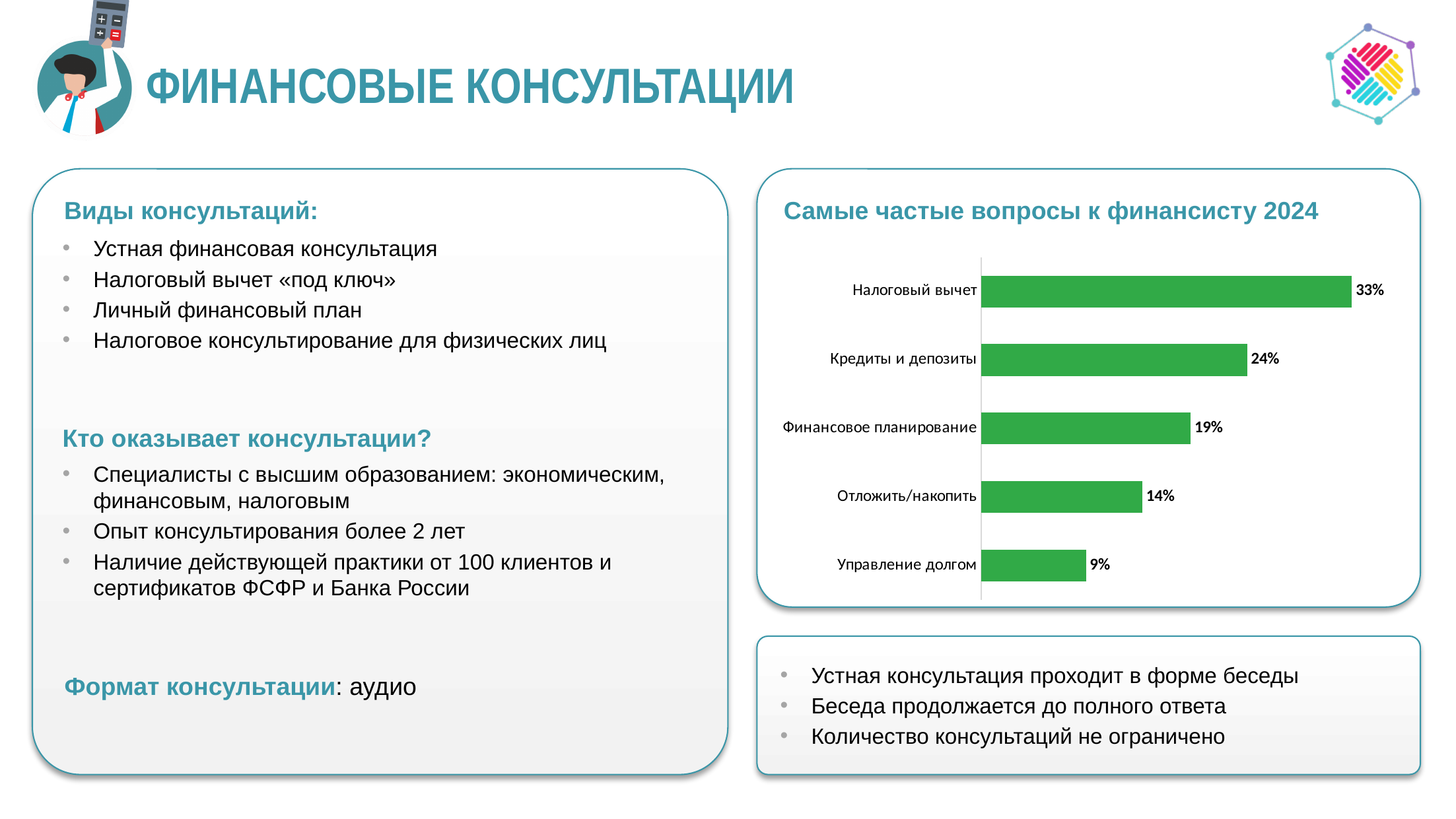
What is the difference between the values for Налоговый вычет and Кредиты и депозиты? 9% How many categories are shown in the chart? 5 What is the value for Управление долгом? 9% What is the value for Отложить/накопить? 14% Which category has the highest value? Налоговый вычет Which is larger, the value for Финансовое планирование or the value for Отложить/накопить? Финансовое планирование What is the title of the chart? Самые частые вопросы к финансисту 2024 What is the value for Финансовое планирование? 19% What is the value for Кредиты и депозиты? 24% What kind of chart is shown on the slide? Bar chart Which category has the lowest value? Управление долгом What is the value for Налоговый вычет? 33%